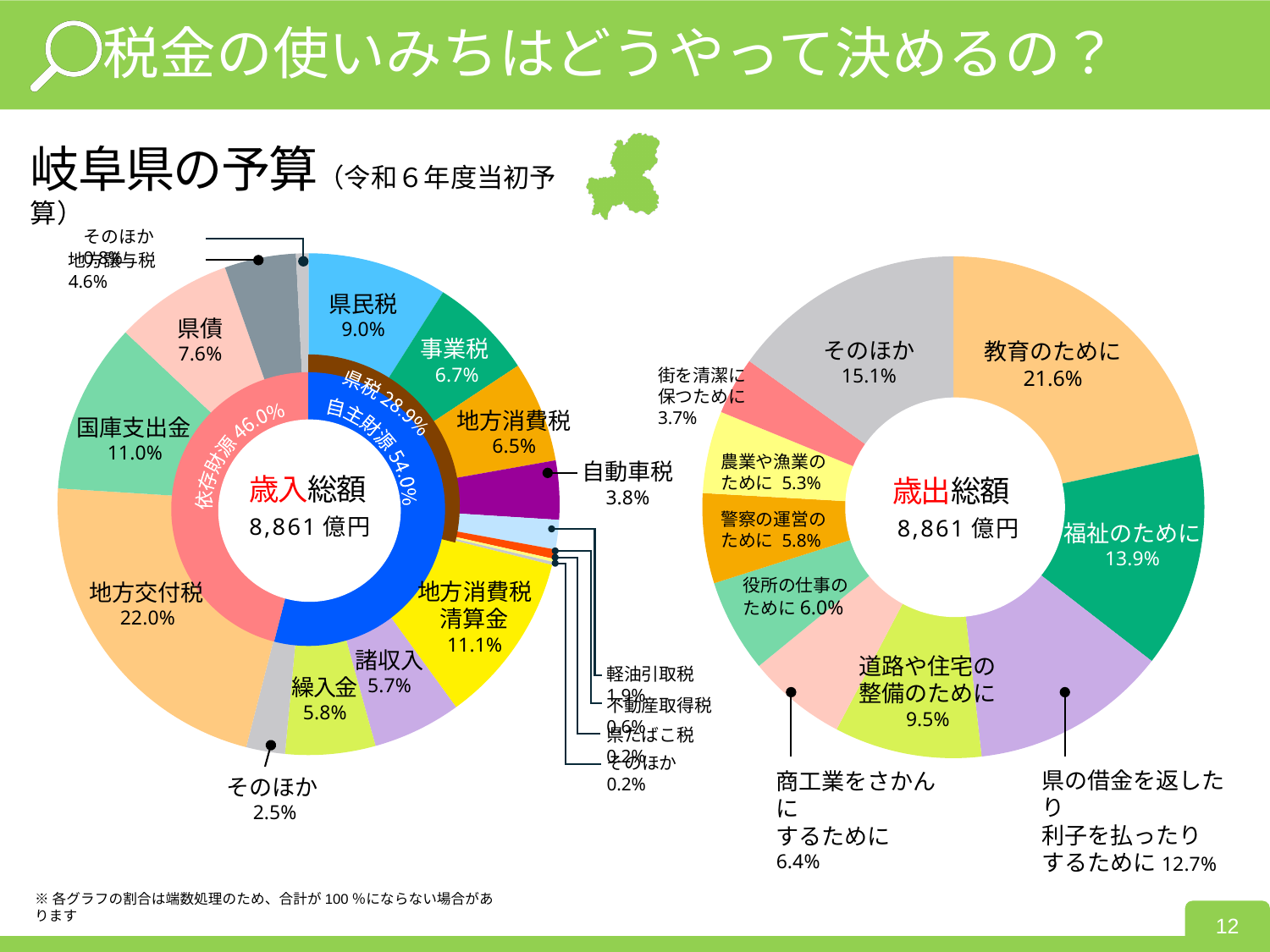
In the 歳入総額 chart on the left, what is the difference between the shares of 地方消費税清算金 and 地方消費税? 4.6% In the 歳出総額 chart on the right, which category has the smallest share? 街を清潔に保つために What type of chart is used for the 歳入総額 chart on the left? Pie (donut) chart In the 歳入総額 chart on the left, what is the share of 自主財源 shown in the inner ring? 54.0% In the 歳出総額 chart on the right, which category has the largest share? 教育のために In the 歳入総額 chart on the left, what share does 地方交付税 have? 22.0% In the 歳出総額 chart on the right, what share does 福祉のために have? 13.9% In the 歳出総額 chart on the right, how many categories are shown? 10 In the 歳入総額 chart on the left, what share does 県民税 have? 9.0% In the 歳出総額 chart on the right, what is the difference between the shares of 教育のために and 道路や住宅の整備のために? 12.1% In the 歳入総額 chart on the left, which is larger, 国庫支出金 or 県債? 国庫支出金 What total amount is shown in the centre of the 歳出総額 chart on the right? 8,861 億円